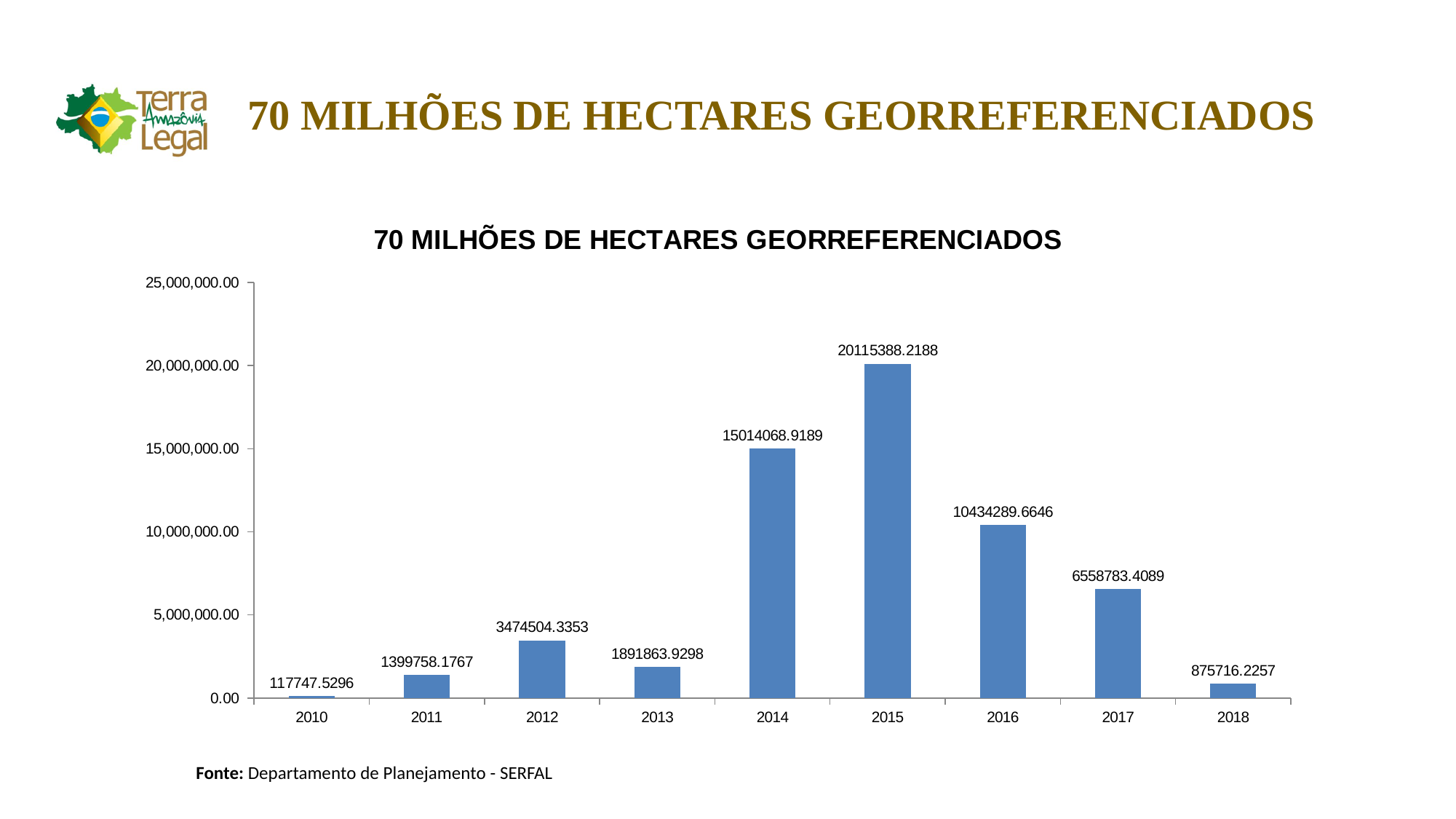
What kind of chart is shown on the slide? bar chart Which year has the highest value? 2015 How many years are shown on the x axis? 9 What is the title of the chart? 70 MILHÕES DE HECTARES GEORREFERENCIADOS Which is larger, the value for 2012 or the value for 2013? 2012 Is the value for 2016 greater or less than 10,000,000.00? greater What is the value for 2015? 20115388.2188 Which year has the lowest value? 2010 What is the value for 2010? 117747.5296 What is the difference between the values for 2015 and 2014? 5101319.2999 What is the value for 2018? 875716.2257 What is the difference between the values for 2016 and 2017? 3875506.2557